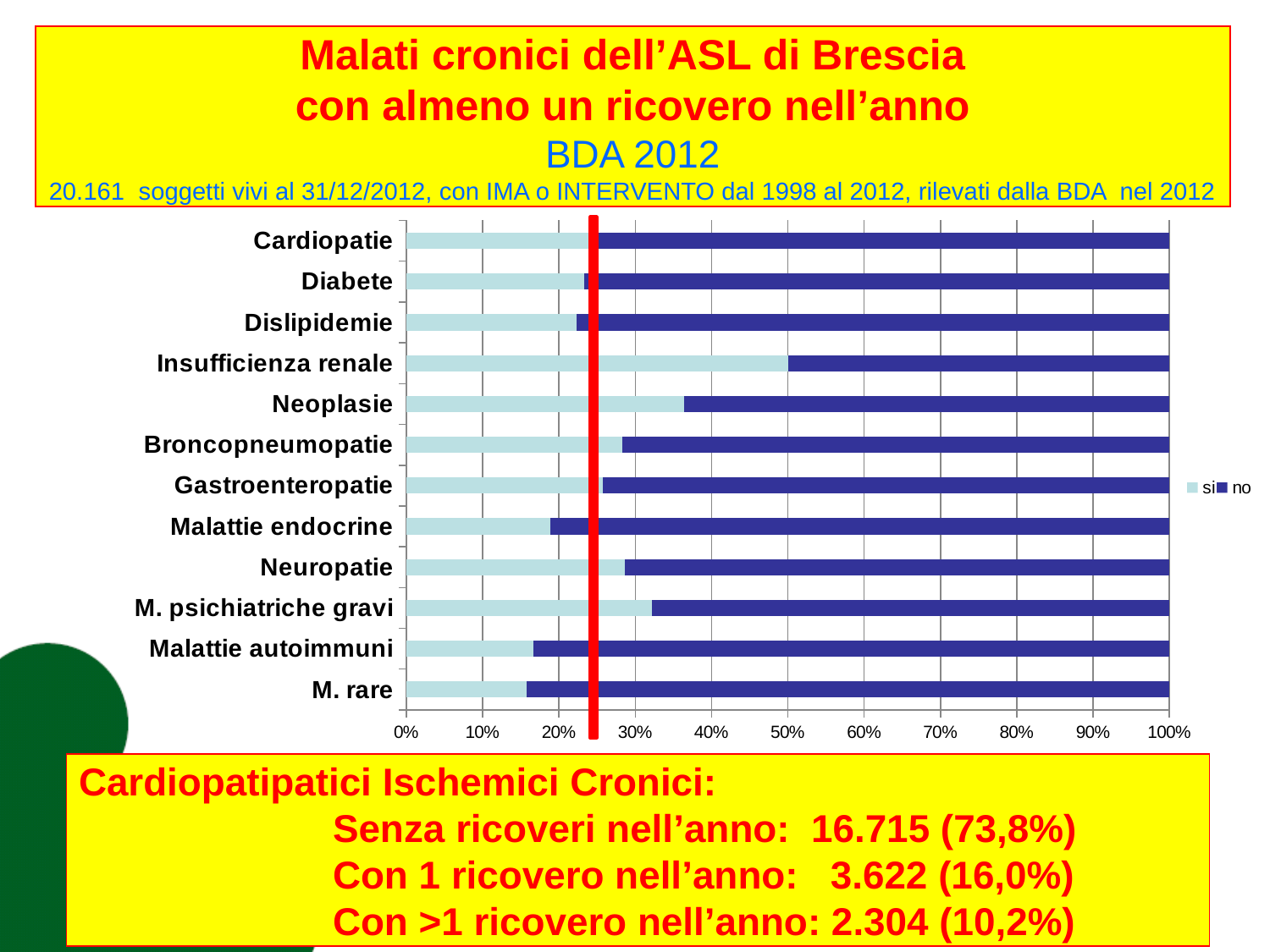
What are the two series named in the chart legend? si and no What is the highest value shown on the horizontal axis of the chart? 100% Is the 'si' share for Malattie endocrine greater or less than 20%? less How many disease categories are plotted on the chart? 12 How many series does the chart legend list? 2 What kind of chart is shown on the slide? bar chart Is the 'si' share for M. psichiatriche gravi greater or less than 30%? greater Which category has the largest 'si' share? Insufficienza renale Is the 'si' share for Neoplasie greater or less than 30%? greater Which has a larger 'si' share, Insufficienza renale or Broncopneumopatie? Insufficienza renale Which has a larger 'si' share, Neoplasie or Diabete? Neoplasie